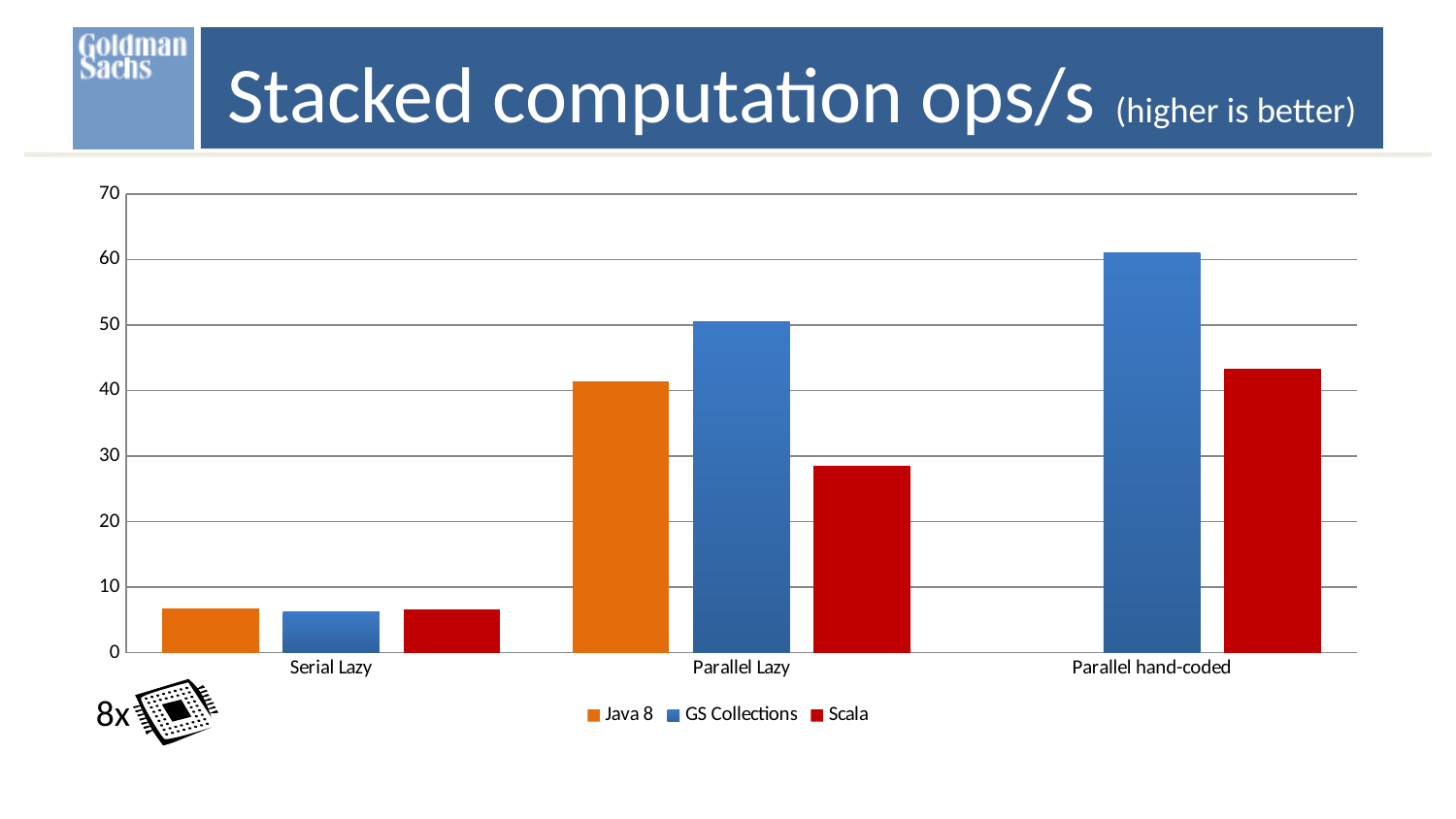
How many bars are plotted in the Parallel hand-coded category? 2 Is the value for GS Collections in Parallel hand-coded greater or less than 50? greater Which category contains the tallest bar in the chart? Parallel hand-coded Which series has the highest bar in the Parallel Lazy category? GS Collections What is the title of the chart? Stacked computation ops/s Which series has the lowest bar in the Parallel Lazy category? Scala Is the value for Scala in Parallel Lazy greater or less than 30? less How many categories are shown on the x axis? 3 Is the value for Java 8 in Serial Lazy greater or less than 10? less How many series does the legend list? 3 What kind of chart is shown on the slide? bar chart In the Parallel Lazy category, which is larger: Java 8 or Scala? Java 8